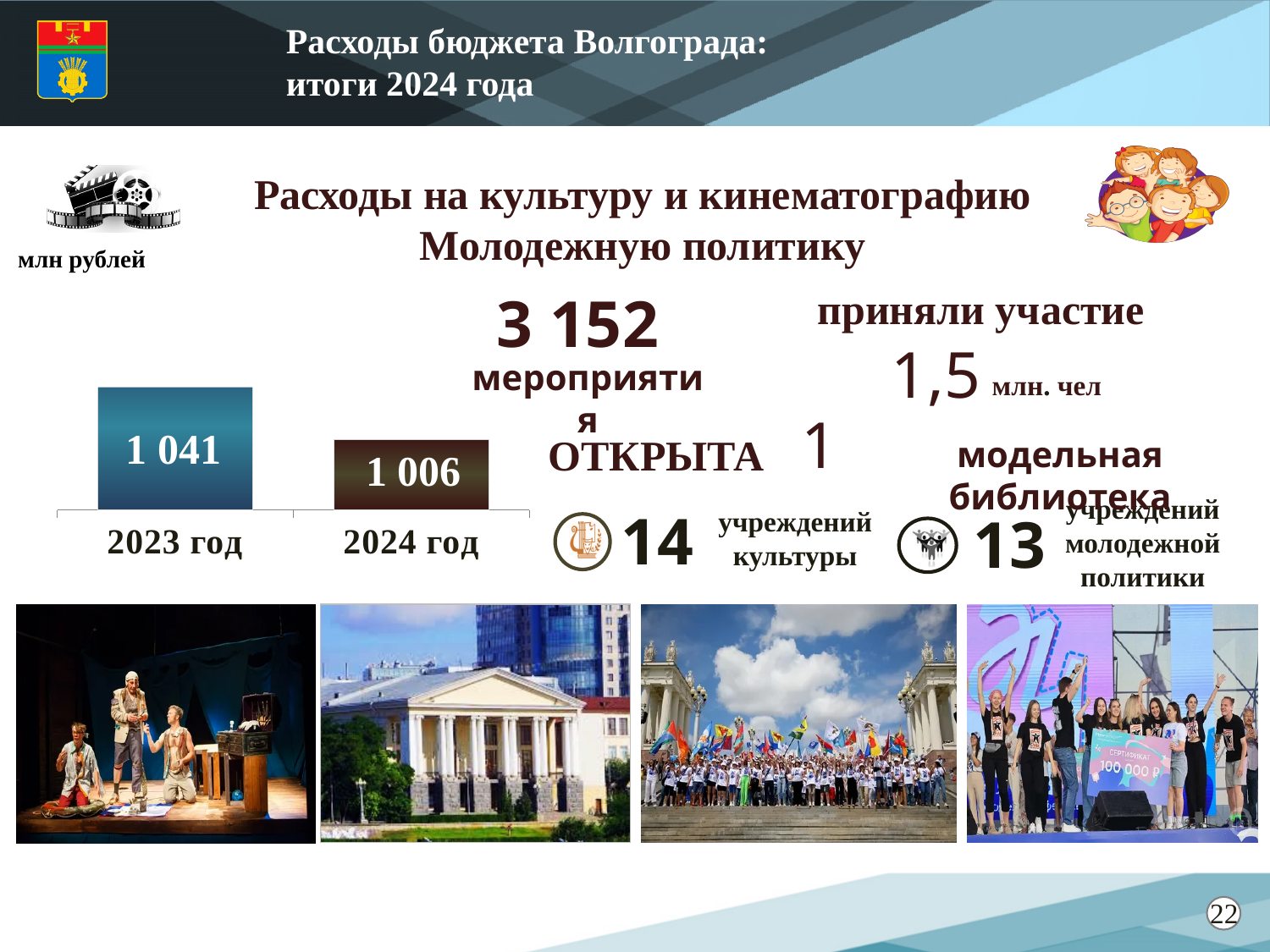
How many bars are shown in the chart? 2 Which year has the higher value in the bar chart? 2023 год Do the values rise or fall from 2023 год to 2024 год? fall What is the title of the chart section on the slide? Расходы на культуру и кинематографию Молодежную политику Which year has the lower value in the bar chart? 2024 год Is the value for 2023 год larger or smaller than the value for 2024 год? larger What is the value for 2023 год in the bar chart? 1 041 What is the difference between the 2023 год and 2024 год values in the bar chart? 35 What unit of measurement is indicated for the bar chart values? млн рублей What kind of chart is shown on the slide? bar chart What is the value for 2024 год in the bar chart? 1 006